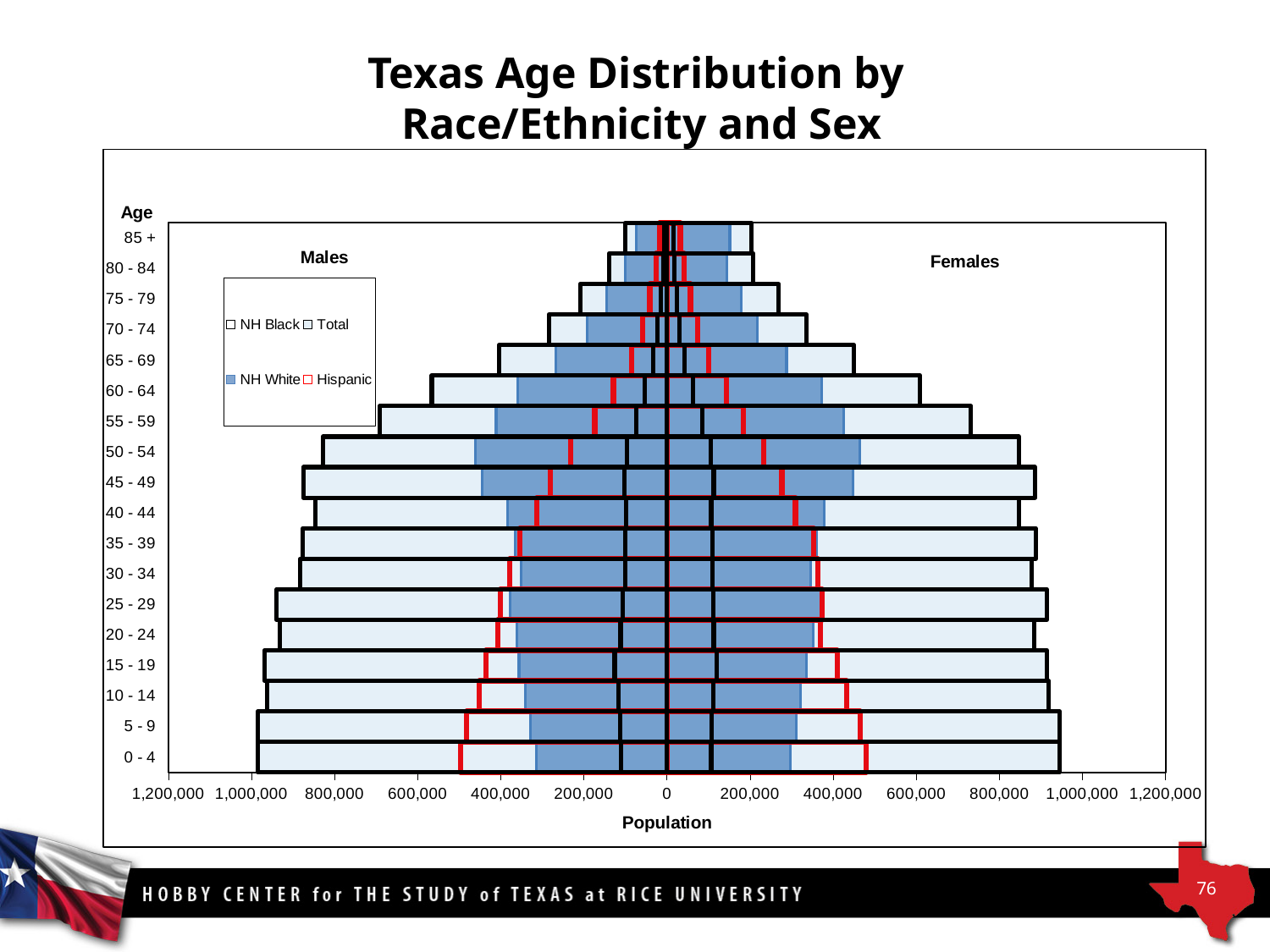
Which age group has the smallest Total population for females? 85 + Is the Total male population for the 0 - 4 age group greater or less than 800,000? greater Is the Total female population for the 55 - 59 age group greater or less than 600,000? greater How many age groups are listed on the vertical axis of the chart? 18 Is the Total female population for the 0 - 4 age group greater or less than 1,000,000? less What is the title of the chart on the slide? Texas Age Distribution by Race/Ethnicity and Sex Which is larger, the Total male population for the 0 - 4 age group or for the 65 - 69 age group? 0 - 4 Which age group has the smallest Total population for males? 85 + What kind of chart is shown on the slide? bar chart How many series does the chart's legend list? 4 Does the Total population generally rise or fall as age increases from 0 - 4 to 85 +? fall